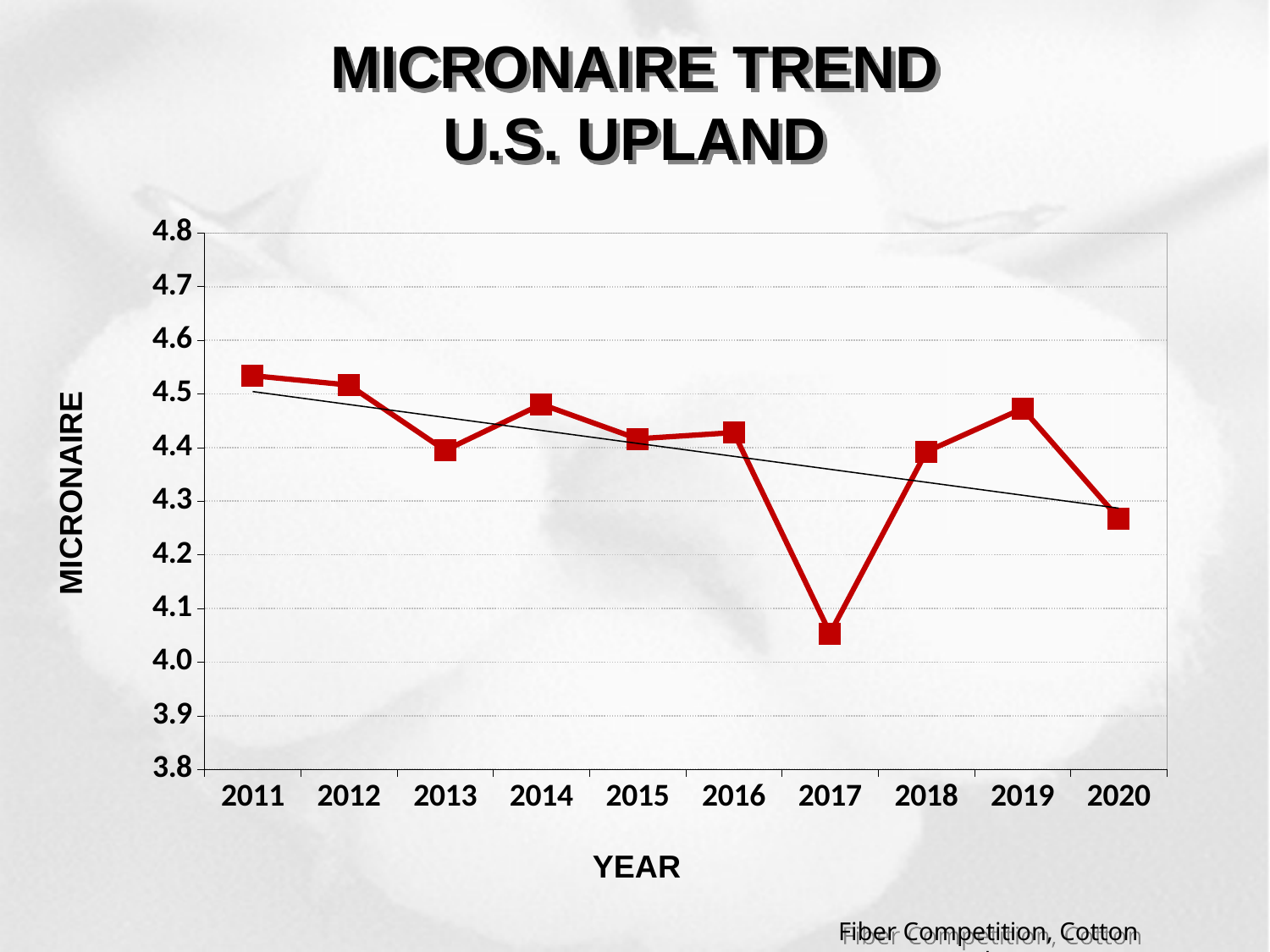
What is the label on the y axis of the chart? MICRONAIRE Is the micronaire value for 2011 greater or less than 4.5? greater Which year has the larger micronaire value, 2017 or 2020? 2020 Is the micronaire value for 2013 greater or less than 4.5? less What kind of chart is shown on the slide? line chart How many years are plotted on the x axis? 10 Is the micronaire value for 2017 greater or less than 4.1? less Which year has the larger micronaire value, 2011 or 2013? 2011 Which year has the lowest micronaire value? 2017 Overall, do micronaire values rise or fall from 2011 to 2020? fall